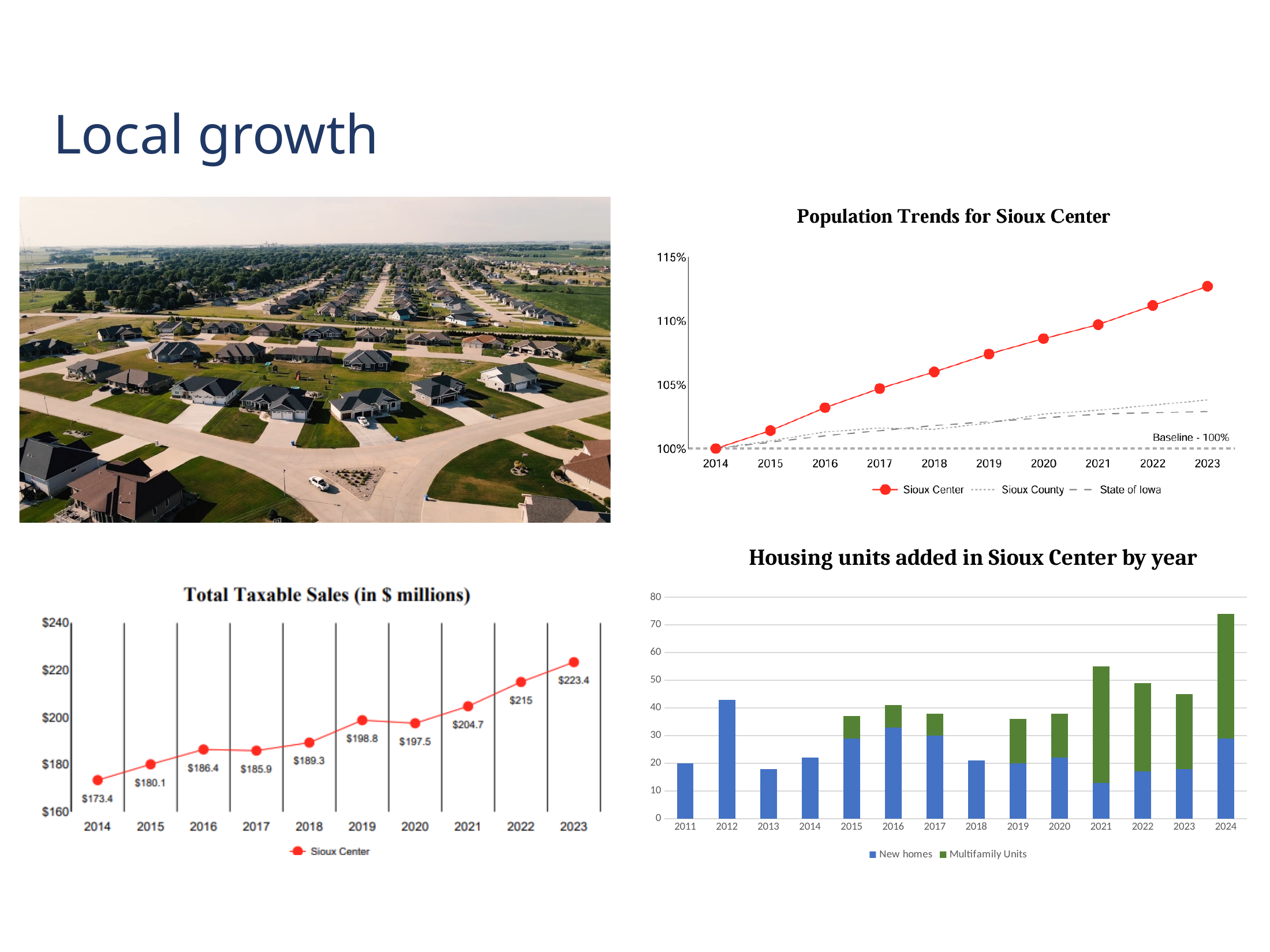
On the Housing units added in Sioux Center by year chart, is the total for 2021 greater or less than 50? greater On the Total Taxable Sales chart, what is the difference between the 2023 and 2022 values? $8.4 What kind of chart is the Housing units added in Sioux Center by year chart? stacked bar chart On the Total Taxable Sales chart, which year has the lowest value? 2014 On the Population Trends for Sioux Center chart, does the Sioux Center line rise or fall from 2014 to 2023? rises On the Total Taxable Sales chart, which is larger, the value for 2019 or the value for 2020? 2019 On the Population Trends for Sioux Center chart, how many series does the legend list? 3 On the Housing units added in Sioux Center by year chart, which year has the highest total? 2024 On the Total Taxable Sales chart, how many years are plotted? 10 On the Population Trends for Sioux Center chart, is the Sioux Center value for 2023 greater or less than 110%? greater On the Total Taxable Sales chart, what is the value for 2023? $223.4 On the Total Taxable Sales chart, what is the value for 2014? $173.4